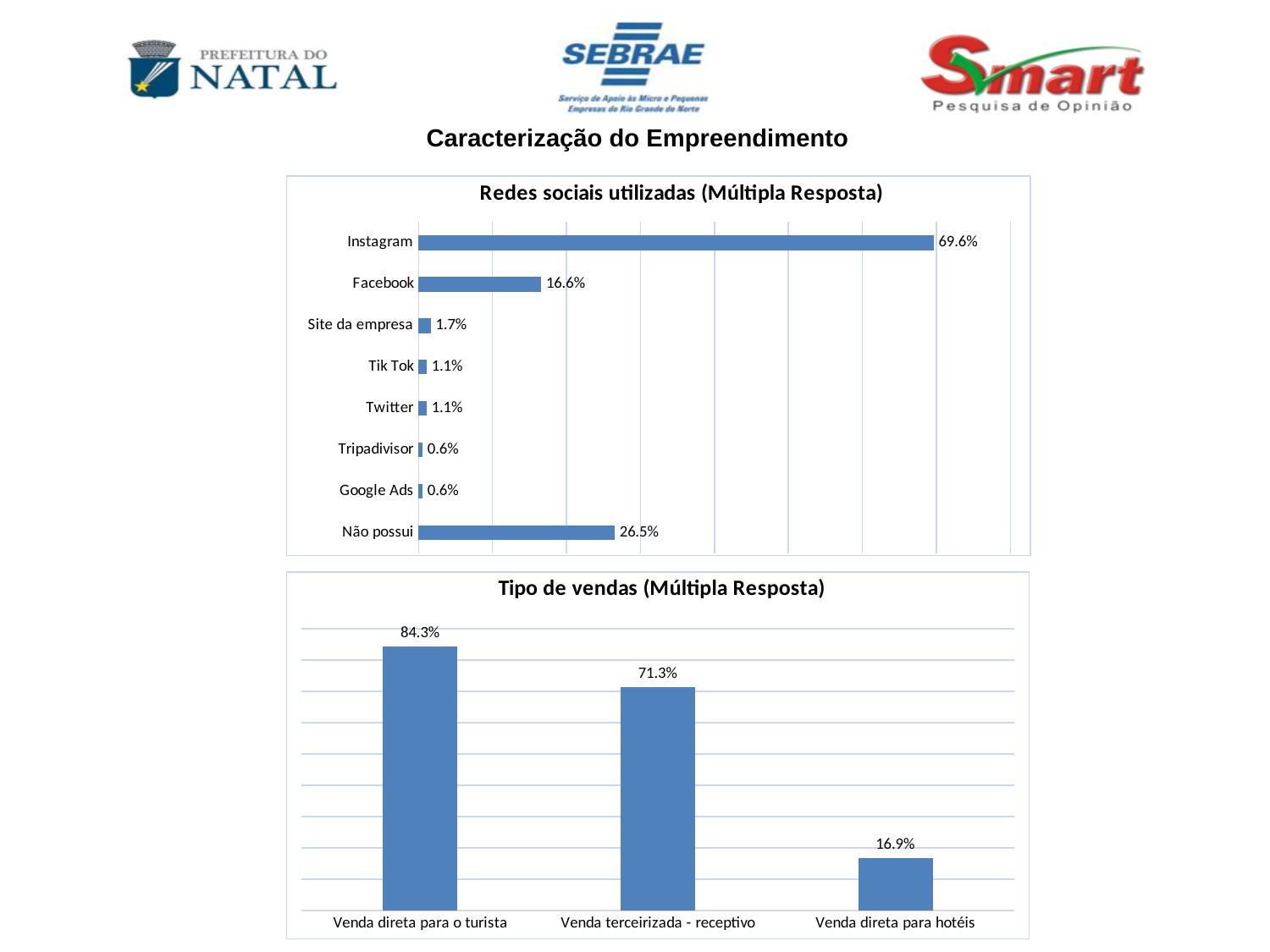
What kind of chart is 'Tipo de vendas (Múltipla Resposta)'? Bar chart In the 'Tipo de vendas (Múltipla Resposta)' chart, how many categories are shown? 3 In the 'Redes sociais utilizadas (Múltipla Resposta)' chart, what is the value for Não possui? 26.5% In the 'Tipo de vendas (Múltipla Resposta)' chart, what is the value for Venda terceirizada - receptivo? 71.3% In the 'Tipo de vendas (Múltipla Resposta)' chart, which category has the lowest value? Venda direta para hotéis In the 'Redes sociais utilizadas (Múltipla Resposta)' chart, which is larger, Facebook or Não possui? Não possui In the 'Redes sociais utilizadas (Múltipla Resposta)' chart, what is the value for Site da empresa? 1.7% In the 'Redes sociais utilizadas (Múltipla Resposta)' chart, what is the value for Instagram? 69.6% In the 'Redes sociais utilizadas (Múltipla Resposta)' chart, which category has the highest value? Instagram In the 'Redes sociais utilizadas (Múltipla Resposta)' chart, how many categories are shown? 8 In the 'Redes sociais utilizadas (Múltipla Resposta)' chart, what is the difference between Instagram and Facebook? 53.0% In the 'Tipo de vendas (Múltipla Resposta)' chart, what is the difference between Venda direta para o turista and Venda direta para hotéis? 67.4%